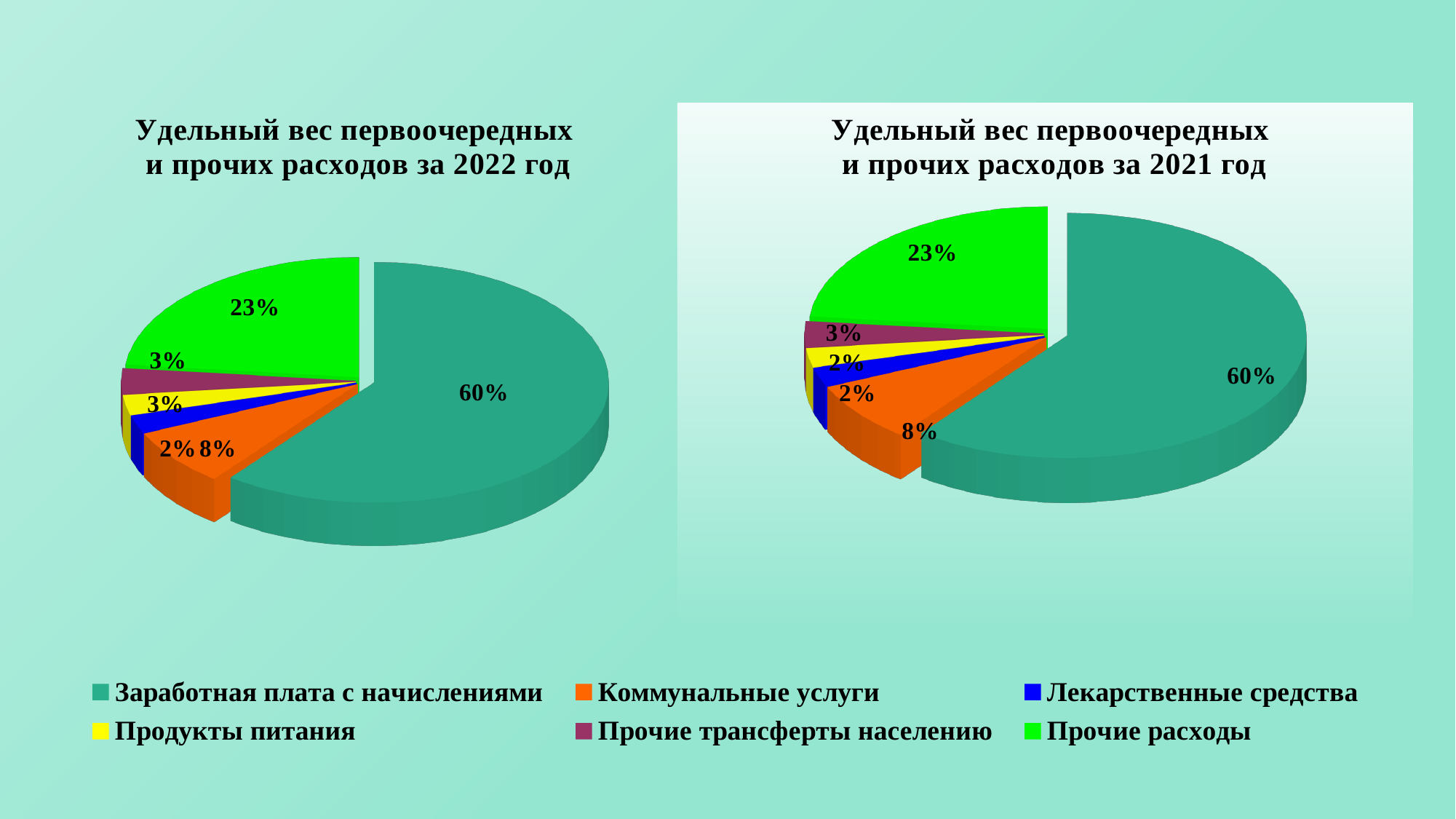
In the chart for 2022 (left), what share is shown for Продукты питания? 3% What type of chart is used on this slide? Pie chart In the chart for 2021 (right), what share is shown for Коммунальные услуги? 8% In the chart for 2022 (left), what share is shown for Прочие трансферты населению? 3% How many categories does the legend list? 6 In the chart for 2021 (right), which category has the smallest slice? Лекарственные средства and Продукты питания (2% each) In the chart for 2022 (left), what is the difference between the shares of Прочие расходы and Коммунальные услуги? 15% What is the title of the chart on the right? Удельный вес первоочередных и прочих расходов за 2021 год In the chart for 2021 (right), what share is shown for Продукты питания? 2% In the chart for 2022 (left), which category has the largest slice? Заработная плата с начислениями In the chart for 2021 (right), which is larger: Прочие расходы or Коммунальные услуги? Прочие расходы In the chart for 2022 (left), what share is shown for Заработная плата с начислениями? 60%